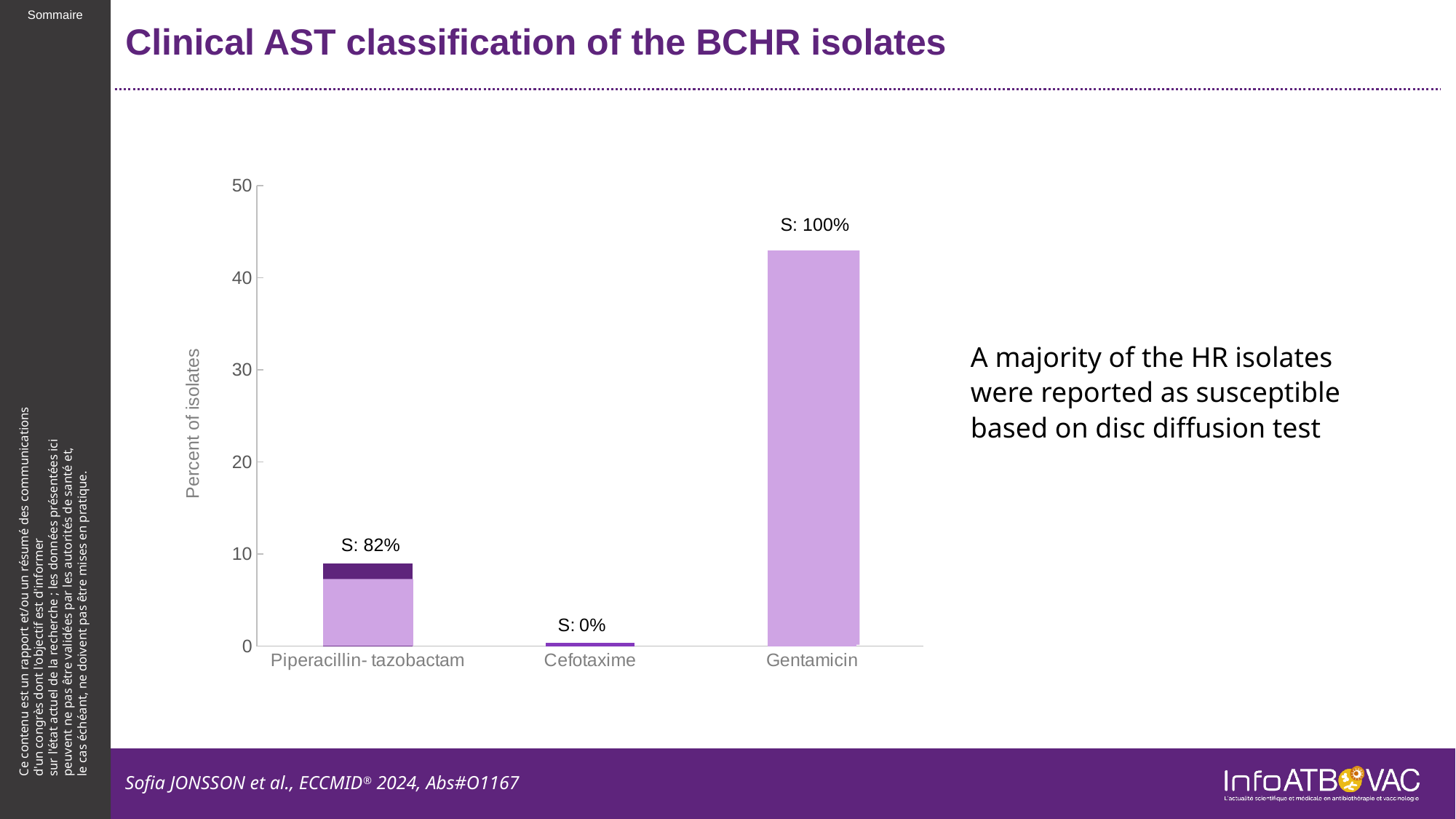
Is the value for Piperacillin-tazobactam greater or less than 10? less What is the label of the y axis? Percent of isolates Which antibiotic has the tallest bar? Gentamicin What is the title of the slide containing the chart? Clinical AST classification of the BCHR isolates Which antibiotic has the shortest bar? Cefotaxime What is the label printed above the Cefotaxime bar? S: 0% Is the value for Gentamicin greater or less than 40? greater What is the label printed above the Gentamicin bar? S: 100% How many antibiotics are shown on the x axis? 3 What is the label printed above the Piperacillin-tazobactam bar? S: 82% Is the bar for Gentamicin taller or shorter than the bar for Piperacillin-tazobactam? taller What kind of chart is shown on the slide? bar chart